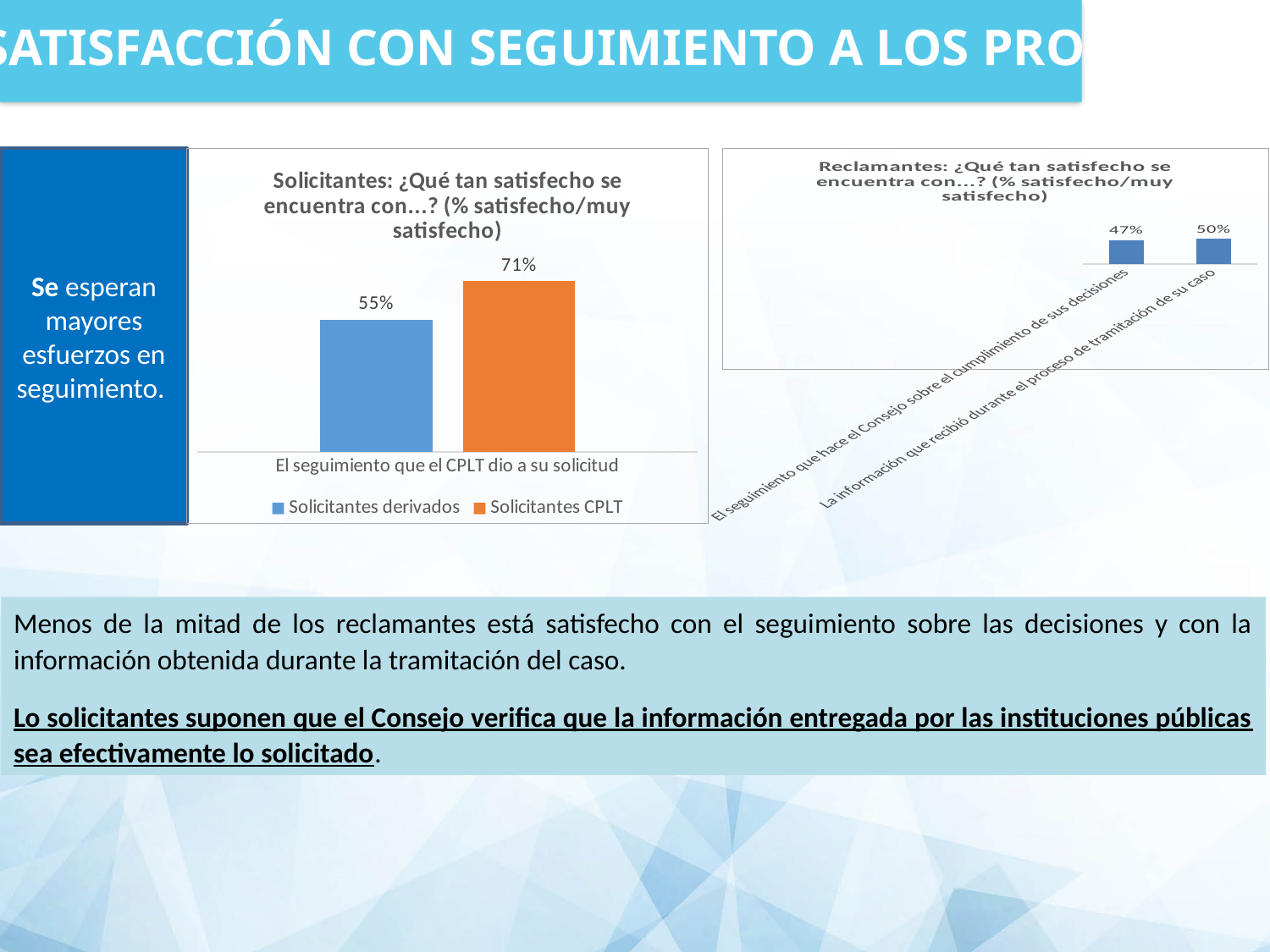
In the left chart (Solicitantes), what is the value for Solicitantes CPLT? 71% In the right chart (Reclamantes), which category has the lowest value? El seguimiento que hace el Consejo sobre el cumplimiento de sus decisiones In the left chart (Solicitantes), what is the value for Solicitantes derivados? 55% What kind of chart is the left chart (Solicitantes)? Bar chart In the left chart (Solicitantes), how many series does the legend list? 2 In the left chart (Solicitantes), which series has the higher value? Solicitantes CPLT In the right chart (Reclamantes), what is the value for 'La información que recibió durante el proceso de tramitación de su caso'? 50% In the right chart (Reclamantes), how many categories are plotted? 2 In the left chart (Solicitantes), what is the difference between Solicitantes CPLT and Solicitantes derivados? 16% In the right chart (Reclamantes), what is the value for 'El seguimiento que hace el Consejo sobre el cumplimiento de sus decisiones'? 47% In the left chart (Solicitantes), what is the category label on the x axis? El seguimiento que el CPLT dio a su solicitud In the right chart (Reclamantes), what is the difference between the two plotted values? 3%